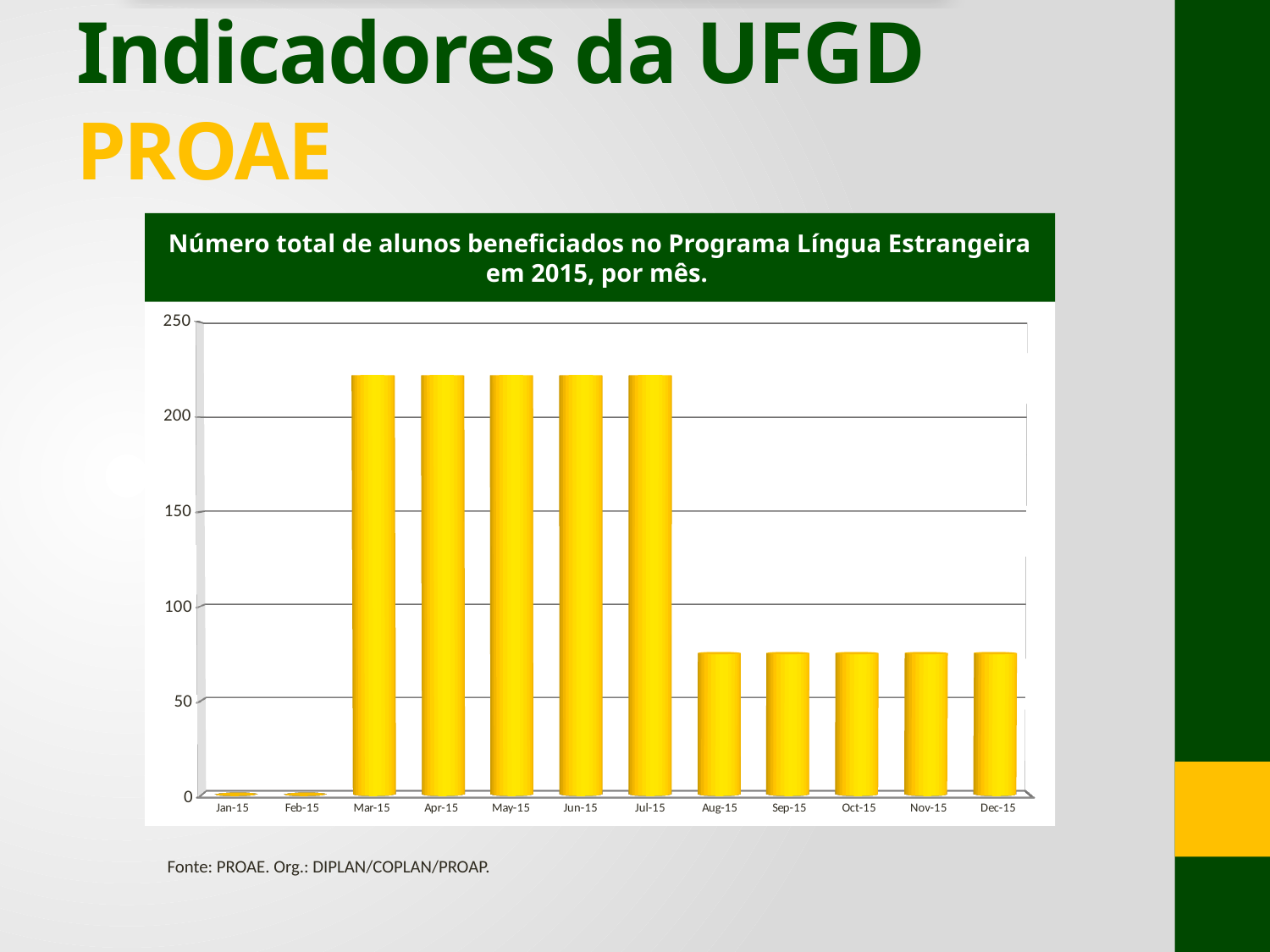
What is the value for Jan-15? 0 Is the value for Mar-15 greater or less than 200? greater Which is larger, the value for May-15 or the value for Oct-15? May-15 Do the values rise or fall from Jul-15 to Aug-15? fall Is the value for Aug-15 greater or less than 100? less Is the value for Dec-15 greater or less than 50? greater What is the value for Feb-15? 0 Do the values rise or fall from Jan-15 to Mar-15? rise What kind of chart is shown on the slide? bar chart What is the title of the chart? Número total de alunos beneficiados no Programa Língua Estrangeira em 2015, por mês. How many months are plotted on the x axis of the chart? 12